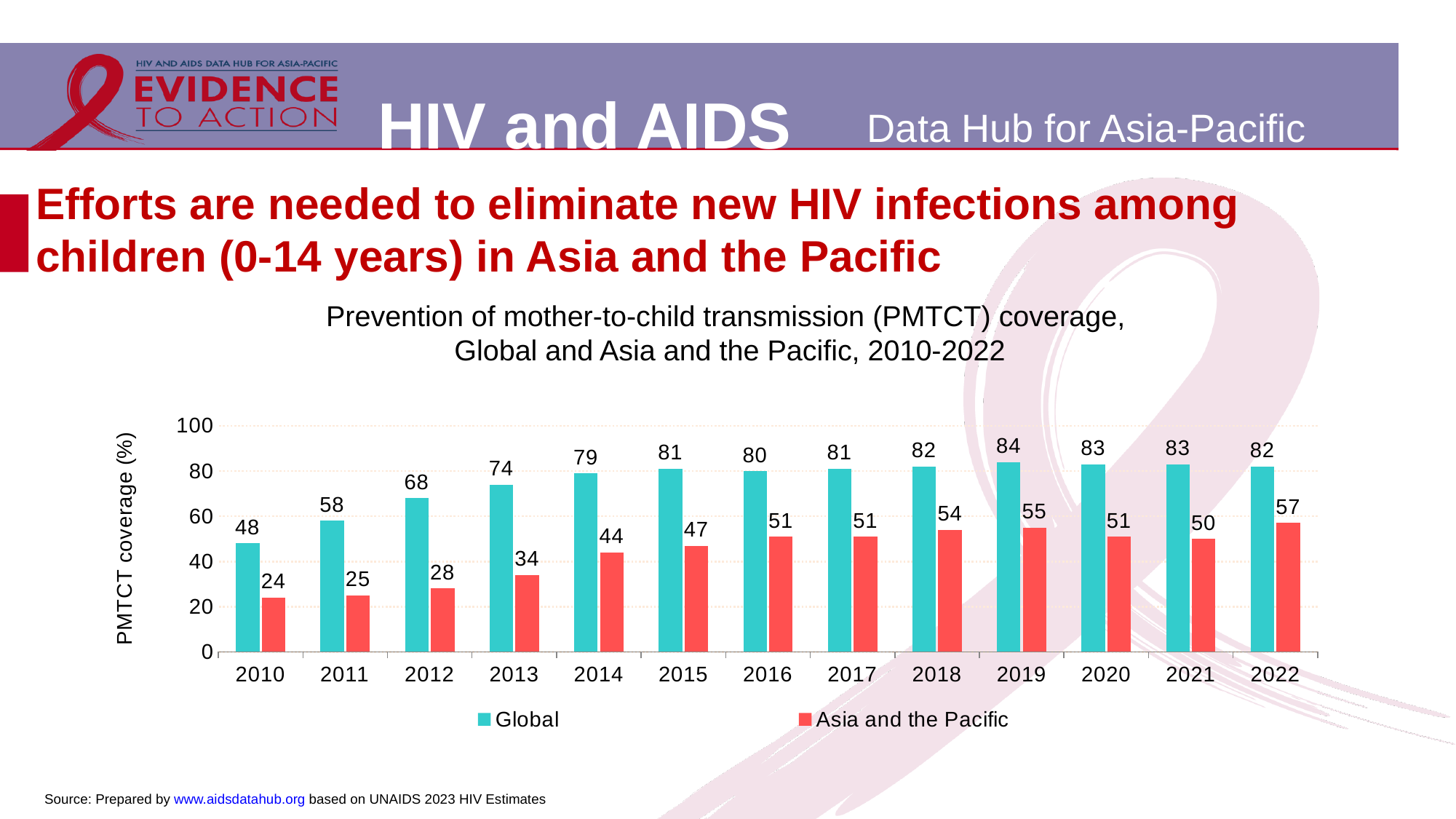
What is the label of the y axis? PMTCT coverage (%) How many years are shown on the x axis? 13 What is the Global PMTCT coverage value for 2010? 48 In which year is the Asia and the Pacific PMTCT coverage lowest? 2010 Does the Asia and the Pacific PMTCT coverage generally rise or fall from 2010 to 2022? Rise What is the Asia and the Pacific PMTCT coverage value for 2022? 57 What is the Asia and the Pacific value for 2013? 34 How many series does the legend list? 2 In which year is the Global PMTCT coverage highest? 2019 Which is larger in 2014: the Global value or the Asia and the Pacific value? Global What kind of chart is shown on the slide? Bar chart What is the difference between the Global and Asia and the Pacific values in 2022? 25